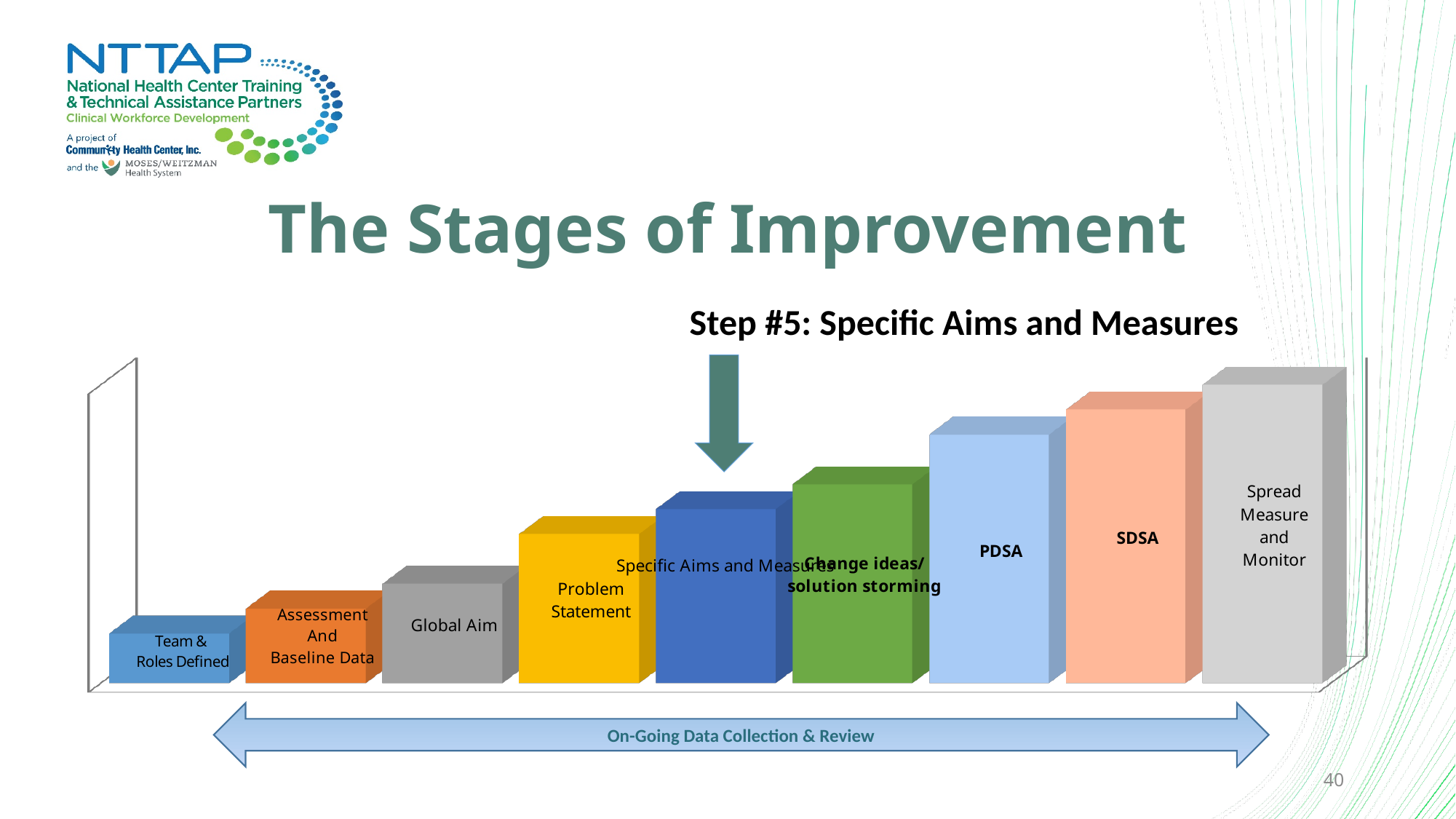
Which bar is taller, SDSA or Change ideas/solution storming? SDSA Which stage has the tallest bar? Spread Measure and Monitor Which bar does the arrow labelled "Step #5: Specific Aims and Measures" point to? Specific Aims and Measures Which bar is taller, Problem Statement or Assessment And Baseline Data? Problem Statement What is the label of the third bar from the left? Global Aim What is the label of the first (leftmost) bar in the chart? Team & Roles Defined Which bar is taller, PDSA or Global Aim? PDSA Do the bars rise or fall from left to right across the chart? rise What is the title of the chart on the slide? The Stages of Improvement How many bars (stages) are shown in the chart? 9 What kind of chart is shown on the slide? bar chart Which stage has the shortest bar? Team & Roles Defined